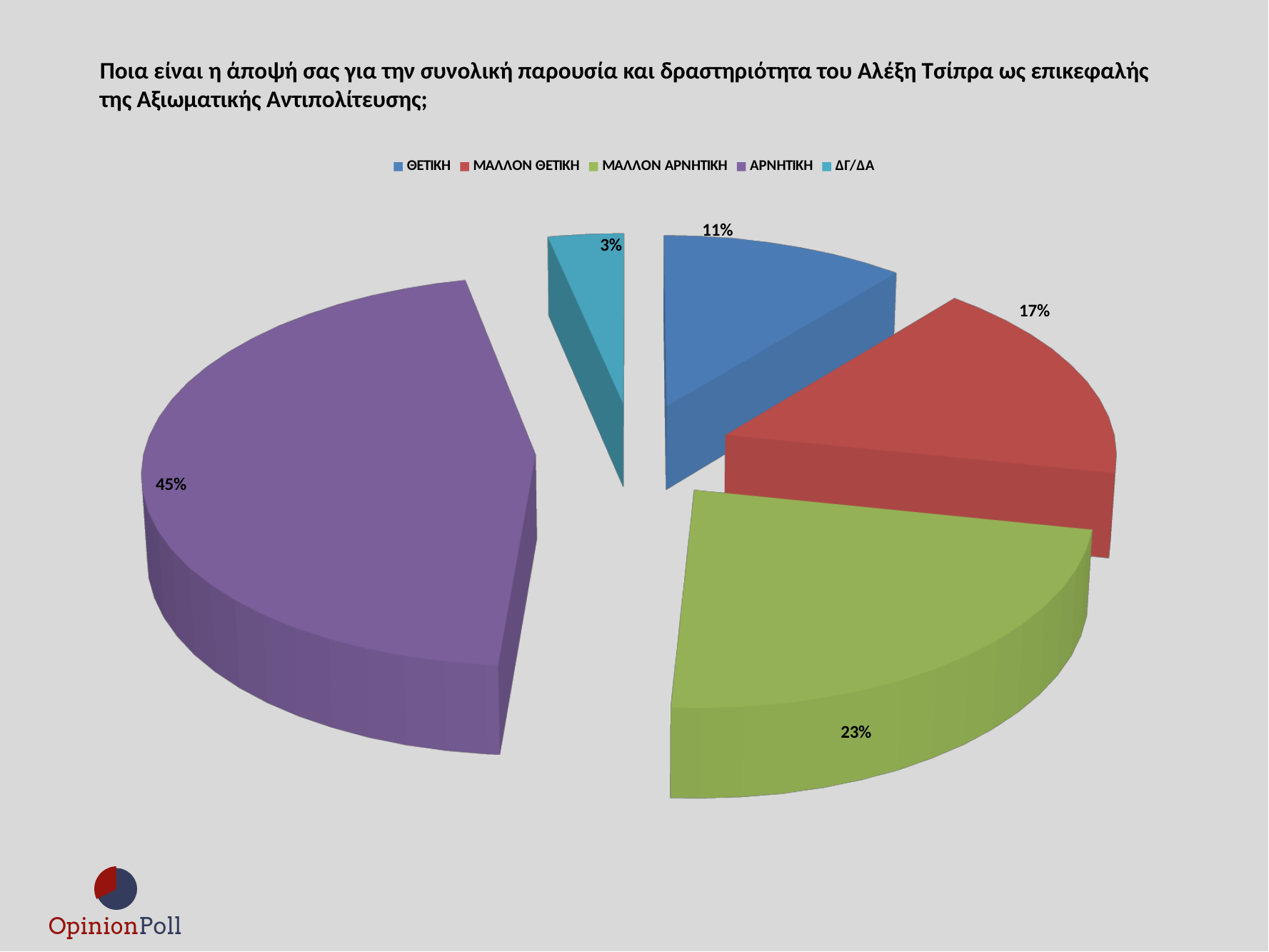
Which category has the smallest slice? ΔΓ/ΔΑ What is the value for ΘΕΤΙΚΗ? 11% What is the value for ΜΑΛΛΟΝ ΘΕΤΙΚΗ? 17% Which is larger, ΜΑΛΛΟΝ ΘΕΤΙΚΗ or ΘΕΤΙΚΗ? ΜΑΛΛΟΝ ΘΕΤΙΚΗ Which category has the largest slice? ΑΡΝΗΤΙΚΗ What colour is the ΑΡΝΗΤΙΚΗ slice? Purple What kind of chart is shown on the slide? Pie chart What share of the pie does ΑΡΝΗΤΙΚΗ have? 45% How many slices does the pie chart have? 5 What is the value for ΜΑΛΛΟΝ ΑΡΝΗΤΙΚΗ? 23% What is the difference between ΑΡΝΗΤΙΚΗ and ΜΑΛΛΟΝ ΑΡΝΗΤΙΚΗ? 22% What is the value for ΔΓ/ΔΑ? 3%